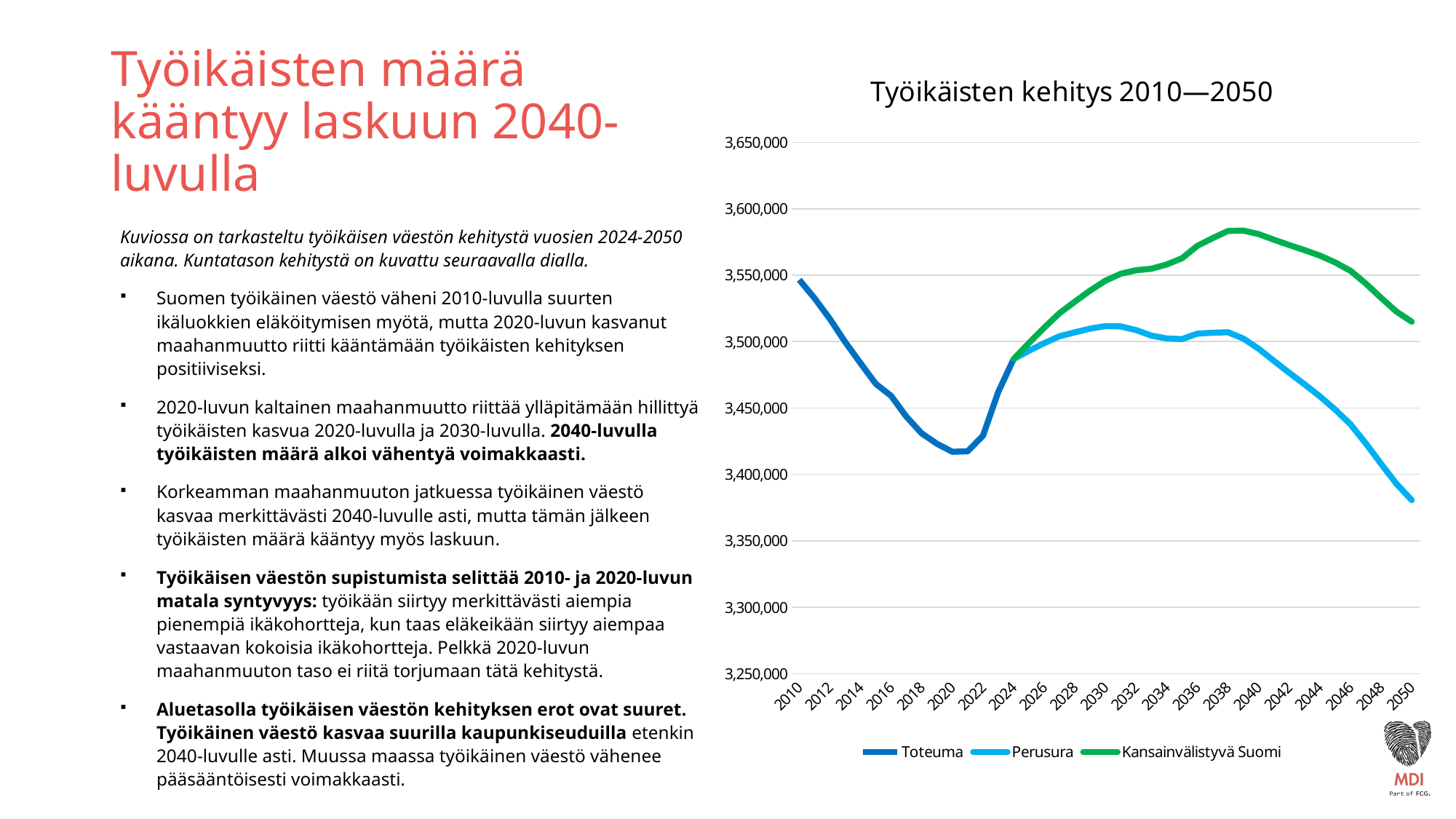
Does the Toteuma series rise or fall between 2010 and 2020? fall Does the Perusura series rise or fall between 2040 and 2050? fall In 2050, which series has the higher value, Perusura or Kansainvälistyvä Suomi? Kansainvälistyvä Suomi Is the value for Toteuma in 2020 greater or less than 3,450,000? less What is the title of the chart? Työikäisten kehitys 2010—2050 Is the value for Kansainvälistyvä Suomi in 2050 greater or less than 3,500,000? greater What kind of chart is shown on the slide? line chart Is the value for Perusura in 2050 greater or less than 3,400,000? less How many series does the legend list? 3 Which series reaches the highest value on the chart? Kansainvälistyvä Suomi Which series is drawn in green? Kansainvälistyvä Suomi